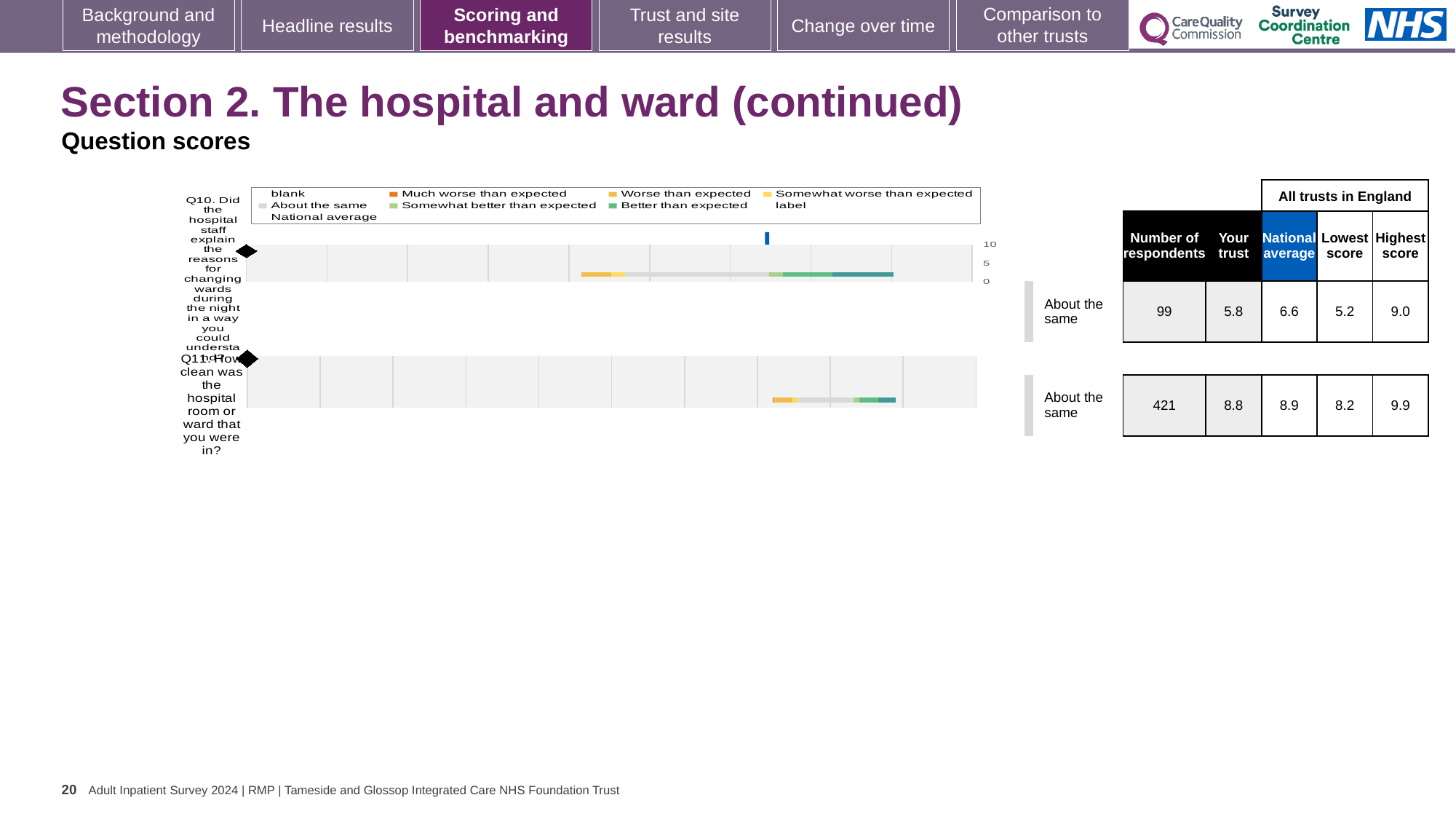
What is the highest score across all trusts in England for Q10? 9.0 How many questions (categories) are plotted in the chart? 2 What is the national average score for Q11 (how clean was the hospital room or ward)? 8.9 What is the difference between the national average and the trust's score for Q10? 0.8 What is the 'Your trust' score for Q10 (explaining reasons for changing wards during the night)? 5.8 What is the lowest score across all trusts in England for Q11? 8.2 How many respondents answered Q11? 421 What benchmark category is shown for Q11? About the same What kind of chart is used to show the question scores on this slide? bar chart Which question has the lower number of respondents? Q10 Which question has the higher 'Your trust' score, Q10 or Q11? Q11 Which legend entry is shown in orange in the chart legend? Much worse than expected